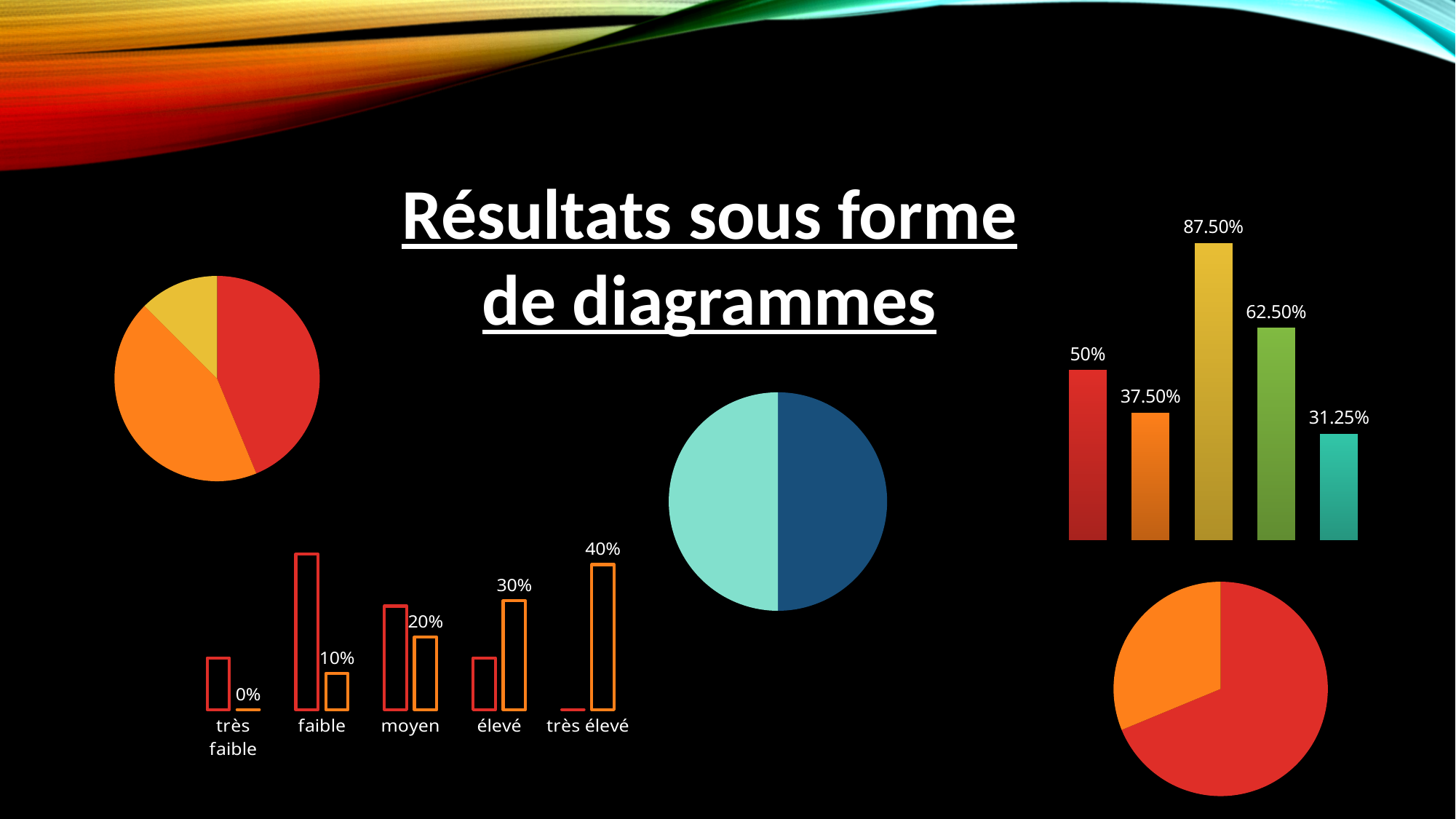
In the bottom-left bar chart, how many categories are shown on the x axis? 5 In the bar chart on the right of the slide, what is the difference between the red bar (50%) and the orange bar (37.50%)? 12.50% In the bar chart on the right of the slide, what is the value of the shortest bar? 31.25% In the bottom-left bar chart, what is the labelled value of the orange bar for 'très élevé'? 40% In the bar chart on the right of the slide, which is larger: the green bar or the teal bar? the green bar (62.50%) In the bottom-left bar chart, do the labelled orange bars rise or fall from 'très faible' to 'très élevé'? rise In the pie chart in the bottom-right of the slide, which slice is larger: the red one or the orange one? the red one In the bottom-left bar chart, what is the labelled value of the orange bar for 'moyen'? 20% In the bar chart on the right of the slide, what is the value of the tallest bar? 87.50% In the bar chart on the right of the slide, how many bars are plotted? 5 How many slices does the pie chart in the top-left of the slide have? 3 In the bar chart on the right of the slide, what is the value of the leftmost (red) bar? 50%